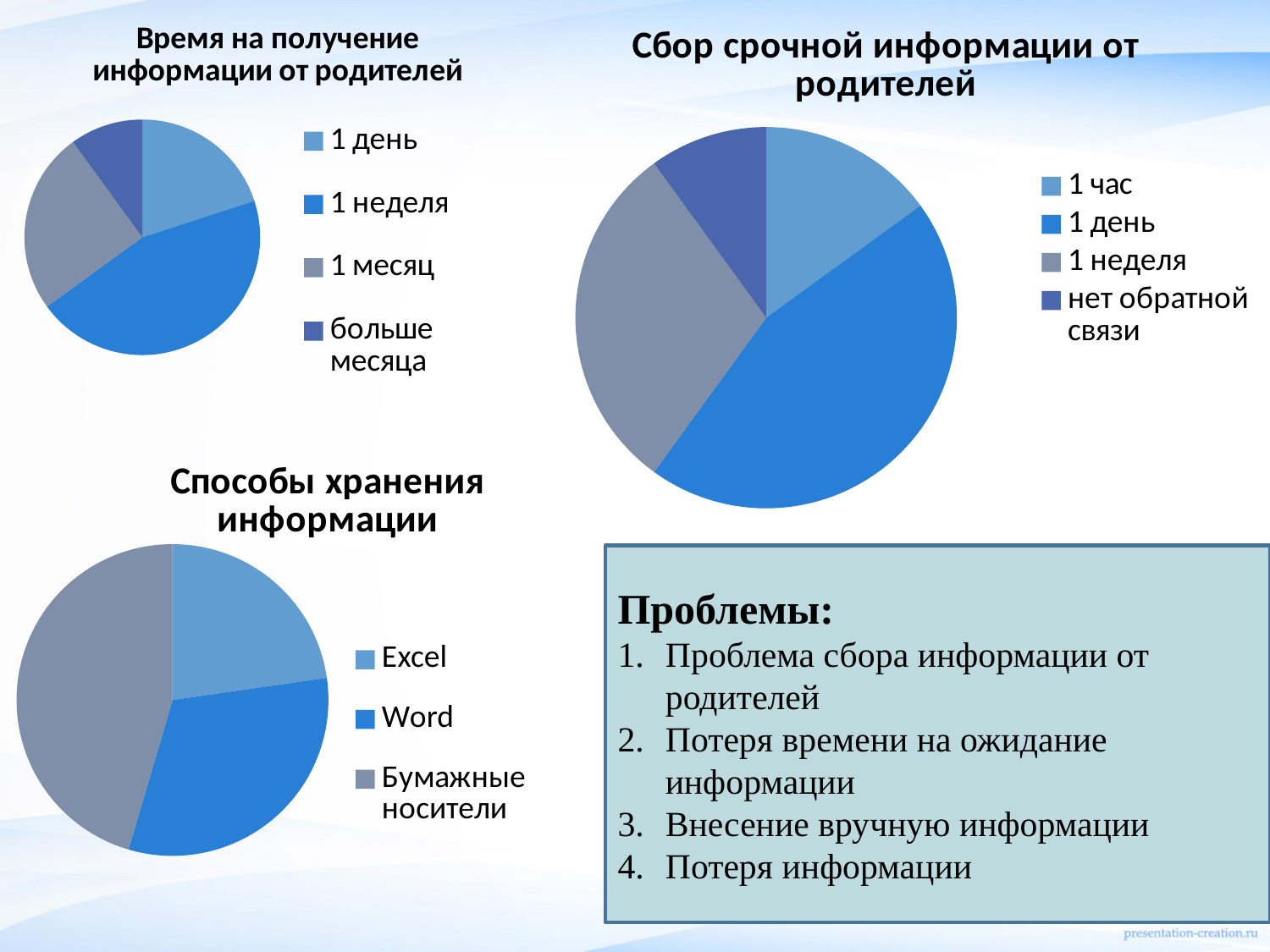
In "Сбор срочной информации от родителей", which category has the smallest slice? нет обратной связи What kind of chart is "Время на получение информации от родителей"? pie chart How many pie charts are shown on the slide? 3 How many categories does the legend of "Способы хранения информации" list? 3 In "Время на получение информации от родителей", which slice is larger: 1 день or 1 неделя? 1 неделя In "Время на получение информации от родителей", which category has the largest slice? 1 неделя In "Время на получение информации от родителей", which category has the smallest slice? больше месяца How many categories does the legend of "Время на получение информации от родителей" list? 4 In "Сбор срочной информации от родителей", which category has the largest slice? 1 день How many categories does the legend of "Сбор срочной информации от родителей" list? 4 In "Сбор срочной информации от родителей", which slice is larger: 1 час or 1 неделя? 1 неделя In "Способы хранения информации", which category has the largest slice? Бумажные носители